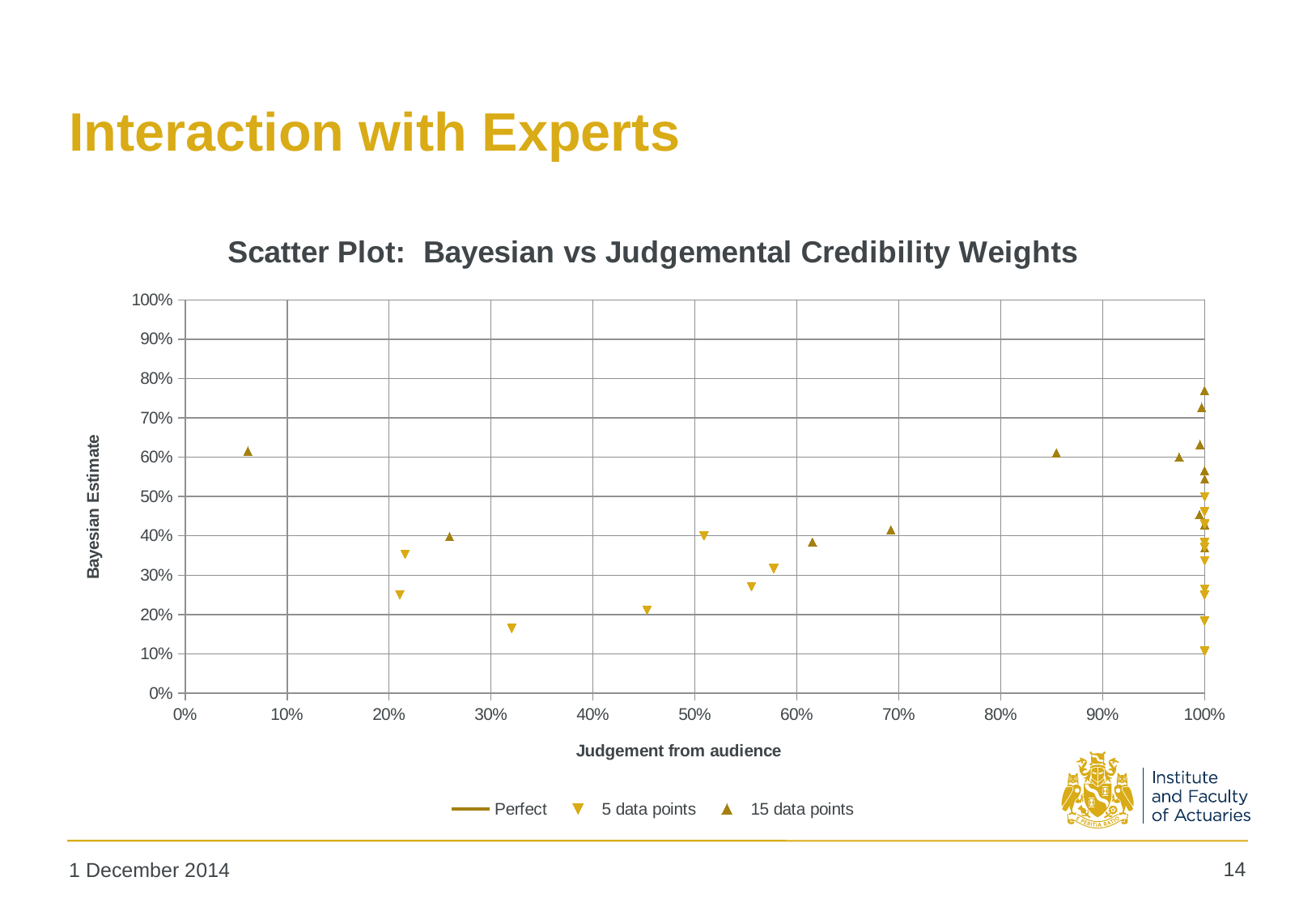
Is the Bayesian Estimate of the point plotted at about 32% judgement from audience greater or less than 20%? less How many series does the legend list? 3 Is the lowest Bayesian Estimate plotted on the chart greater or less than 20%? less Is the Bayesian Estimate of the leftmost plotted point (near 6% judgement from audience) greater or less than 50%? greater What is the title of the chart? Scatter Plot: Bayesian vs Judgemental Credibility Weights What kind of chart is shown on the slide? Scatter plot What is the label of the vertical axis? Bayesian Estimate What is the maximum value shown on the horizontal axis? 100%